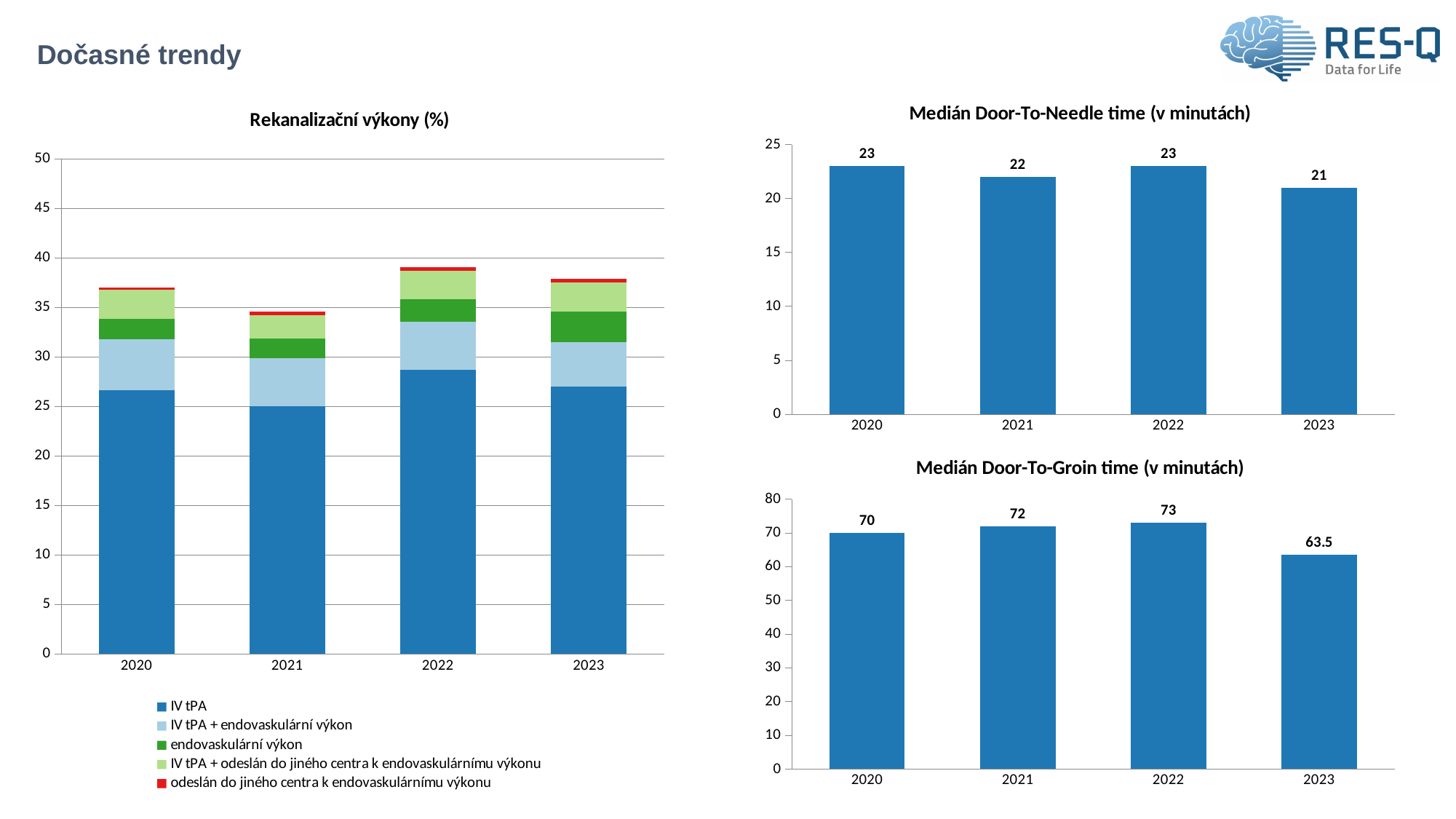
In the Rekanalizační výkony (%) chart, how many series does the legend list? 5 In the Rekanalizační výkony (%) chart, is the total stacked value for 2022 greater or less than 35? greater What kind of chart is the Rekanalizační výkony (%) chart? stacked bar chart In the Medián Door-To-Groin time chart, which is larger, the value for 2020 or the value for 2021? 2021 In the Medián Door-To-Needle time chart, how many years are shown on the x axis? 4 In the Medián Door-To-Groin time chart, what is the value for 2023? 63.5 In the Medián Door-To-Groin time chart, which year has the highest value? 2022 In the Rekanalizační výkony (%) chart, is the IV tPA value for 2022 greater or less than 25? greater In the Medián Door-To-Needle time chart, what is the difference between the values for 2020 and 2021? 1 In the Medián Door-To-Needle time chart, what is the value for 2023? 21 In the Medián Door-To-Needle time chart, which year has the lowest value? 2023 In the Medián Door-To-Groin time chart, what is the difference between the values for 2022 and 2023? 9.5